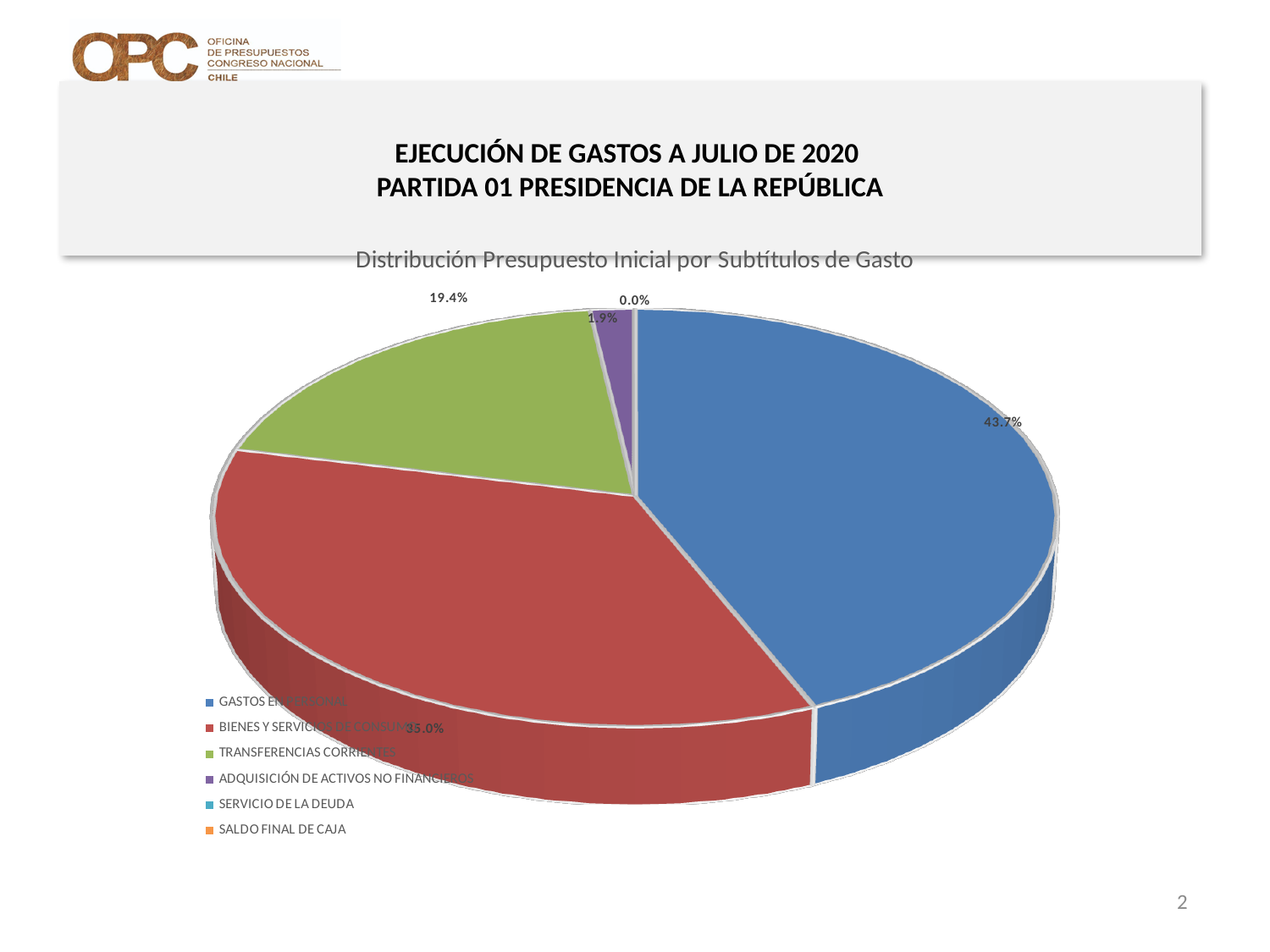
What is the difference in percentage points between the GASTOS EN PERSONAL slice and the BIENES Y SERVICIOS DE CONSUMO slice? 8.7 percentage points How many categories does the legend of the pie chart list? 6 What percentage share does ADQUISICIÓN DE ACTIVOS NO FINANCIEROS have in the pie chart? 1.9% What colour is the GASTOS EN PERSONAL slice in the pie chart? Blue What is the title of the pie chart? Distribución Presupuesto Inicial por Subtítulos de Gasto What is the difference in percentage points between the TRANSFERENCIAS CORRIENTES slice and the ADQUISICIÓN DE ACTIVOS NO FINANCIEROS slice? 17.5 percentage points What percentage share does GASTOS EN PERSONAL have in the pie chart? 43.7% Which category has the largest slice of the pie chart? GASTOS EN PERSONAL What percentage share does TRANSFERENCIAS CORRIENTES have in the pie chart? 19.4% What percentage share does BIENES Y SERVICIOS DE CONSUMO have in the pie chart? 35.0% What type of chart is shown on the slide? Pie chart Which slice is larger, TRANSFERENCIAS CORRIENTES or ADQUISICIÓN DE ACTIVOS NO FINANCIEROS? TRANSFERENCIAS CORRIENTES